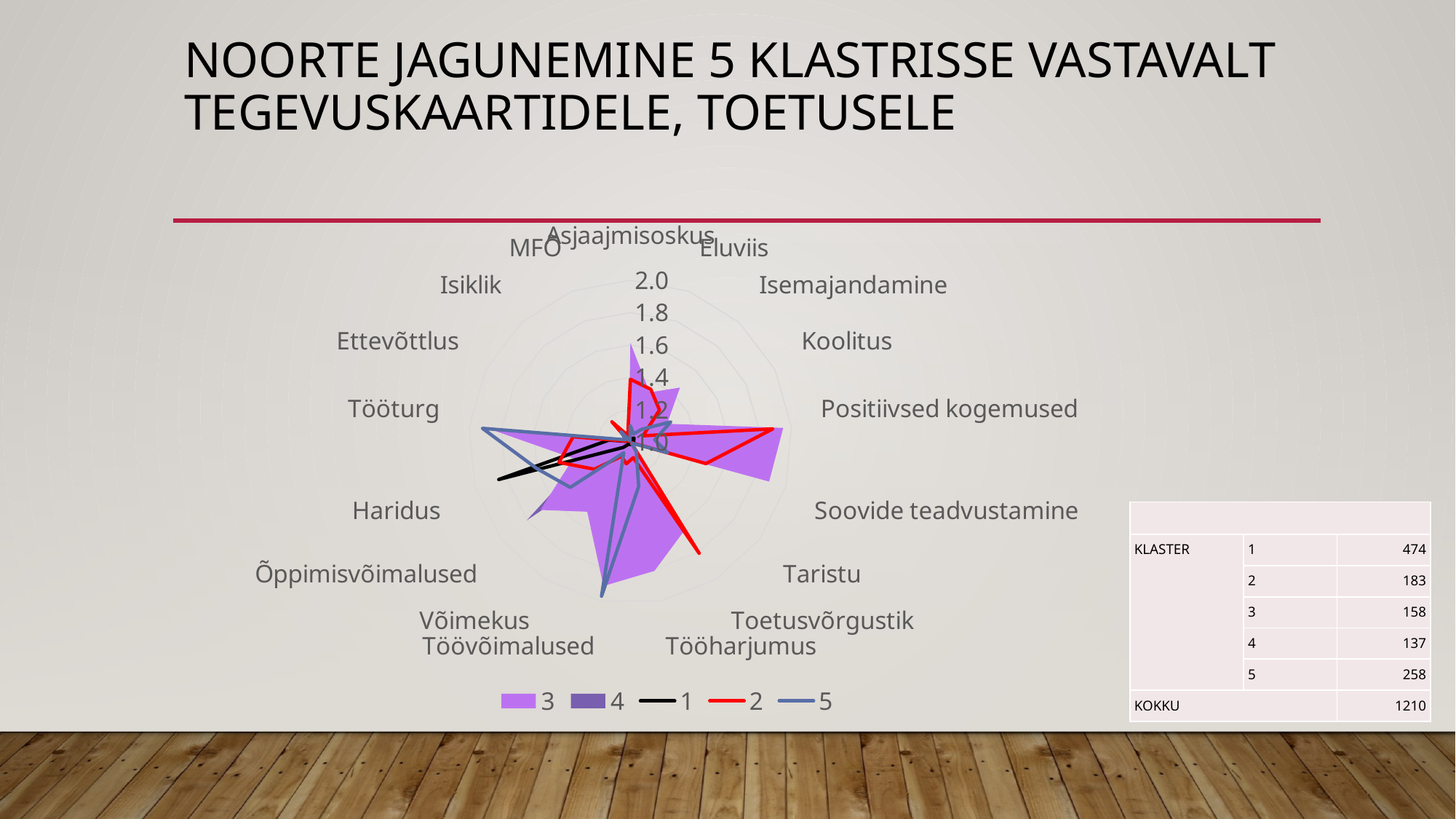
What are the series names listed in the chart legend? 3, 4, 1, 2, 5 Is the value of series 2 for Isemajandamine greater or less than 1.6? less Is the value of series 3 for Positiivsed kogemused greater or less than 1.4? greater Is the value of series 1 for Asjaajmisoskus greater or less than 1.4? less How many categories are plotted around the radar chart? 17 What kind of chart is shown on the slide? Radar chart How many series does the chart legend list? 5 What is the highest value shown on the chart's radial axis? 2.0